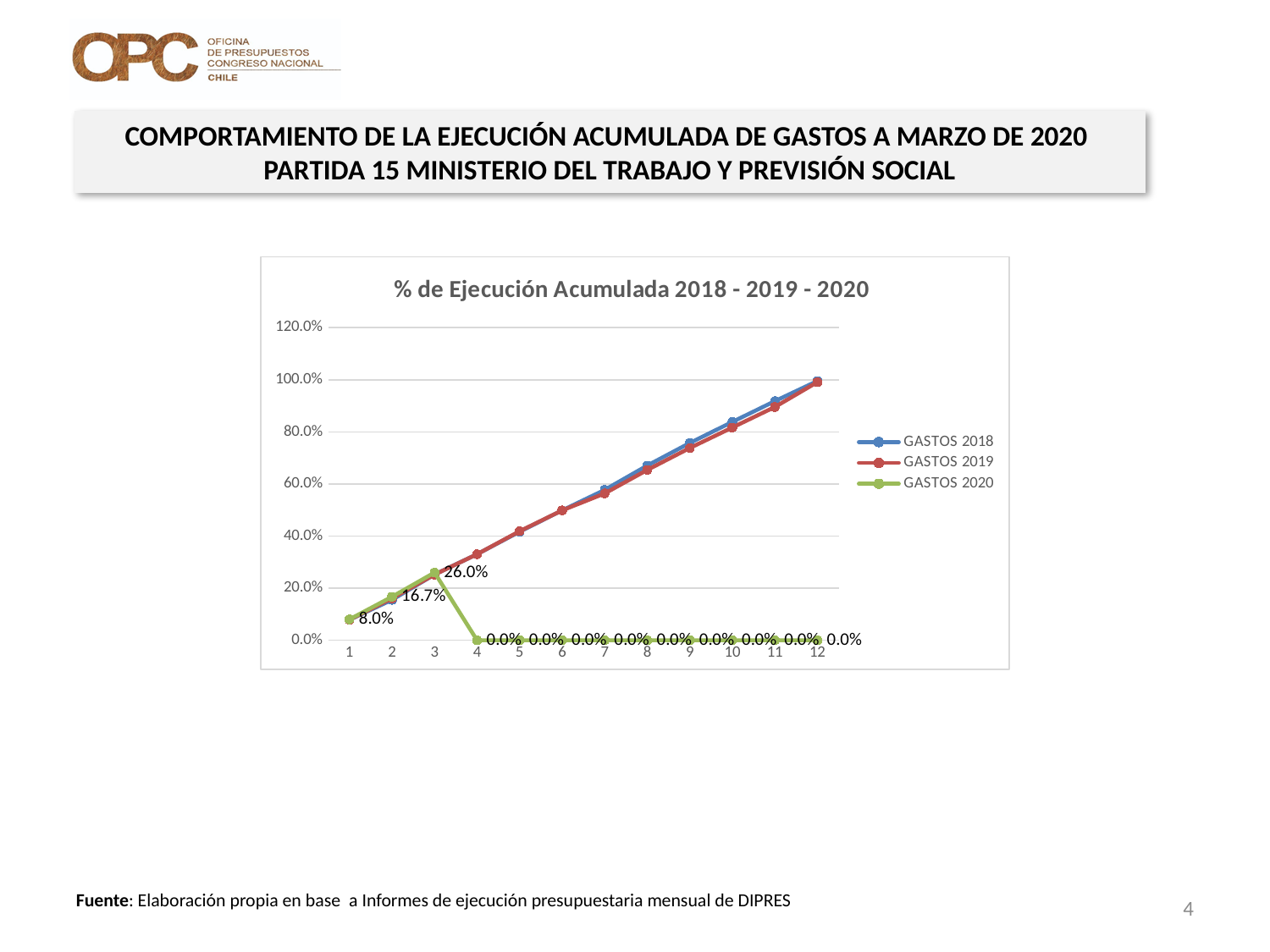
Is the value of GASTOS 2019 at point 12 greater or less than 80.0%? greater How many series does the legend list? 3 What is the value of GASTOS 2020 at point 2? 16.7% What is the value of GASTOS 2020 at point 4? 0.0% At which point on the x axis does GASTOS 2020 reach its highest value? 3 Is the value of GASTOS 2018 at point 6 greater or less than 60.0%? less What is the value of GASTOS 2020 at point 1? 8.0% What is the value of GASTOS 2020 at point 3? 26.0% How many points are shown along the x axis? 12 What is the difference between the GASTOS 2020 values at point 3 and point 2? 9.3% What kind of chart is shown on the slide? line chart Does the GASTOS 2019 series rise or fall from point 1 to point 12? rise